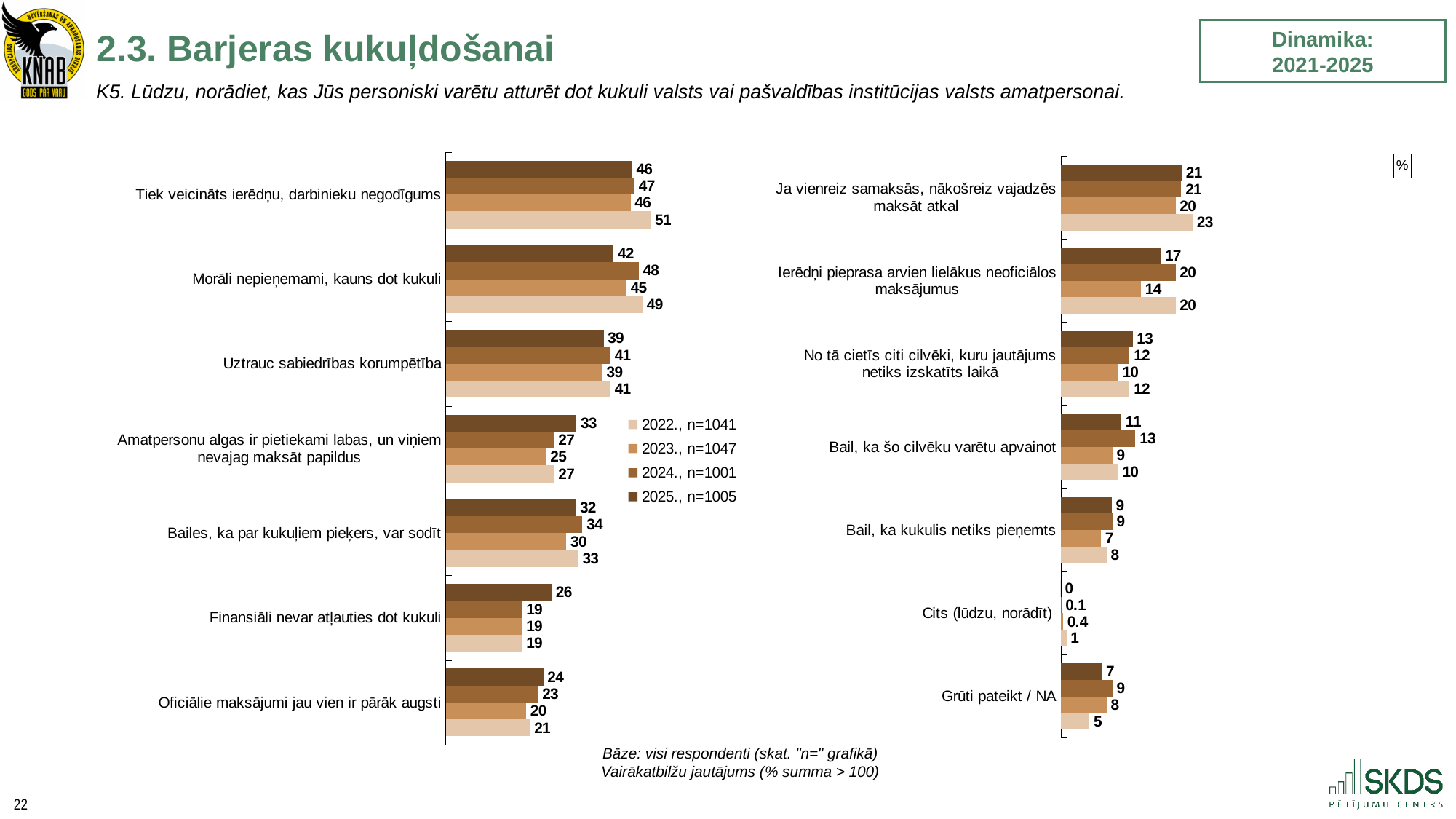
In the right chart, which category has the lowest 2025 value? Cits (lūdzu, norādīt) In the left chart, what is the 2022 value for "Tiek veicināts ierēdņu, darbinieku negodīgums"? 51 In the left chart, which is larger for "Morāli nepieņemami, kauns dot kukuli": the 2024 value or the 2025 value? 2024 How many series does the legend list? 4 In the left chart, what is the difference between the 2025 and 2024 values for "Amatpersonu algas ir pietiekami labas, un viņiem nevajag maksāt papildus"? 6 According to the legend, what is the sample size (n) for 2025? 1005 How many categories are shown in the right chart? 7 In the right chart, what is the 2022 value for "Grūti pateikt / NA"? 5 What type of chart is used on this slide? Bar chart In the right chart, what is the 2023 value for "Ierēdņi pieprasa arvien lielākus neoficiālos maksājumus"? 14 In the left chart, which category has the highest 2025 value? Tiek veicināts ierēdņu, darbinieku negodīgums In the left chart, what is the 2025 value for "Finansiāli nevar atļauties dot kukuli"? 26